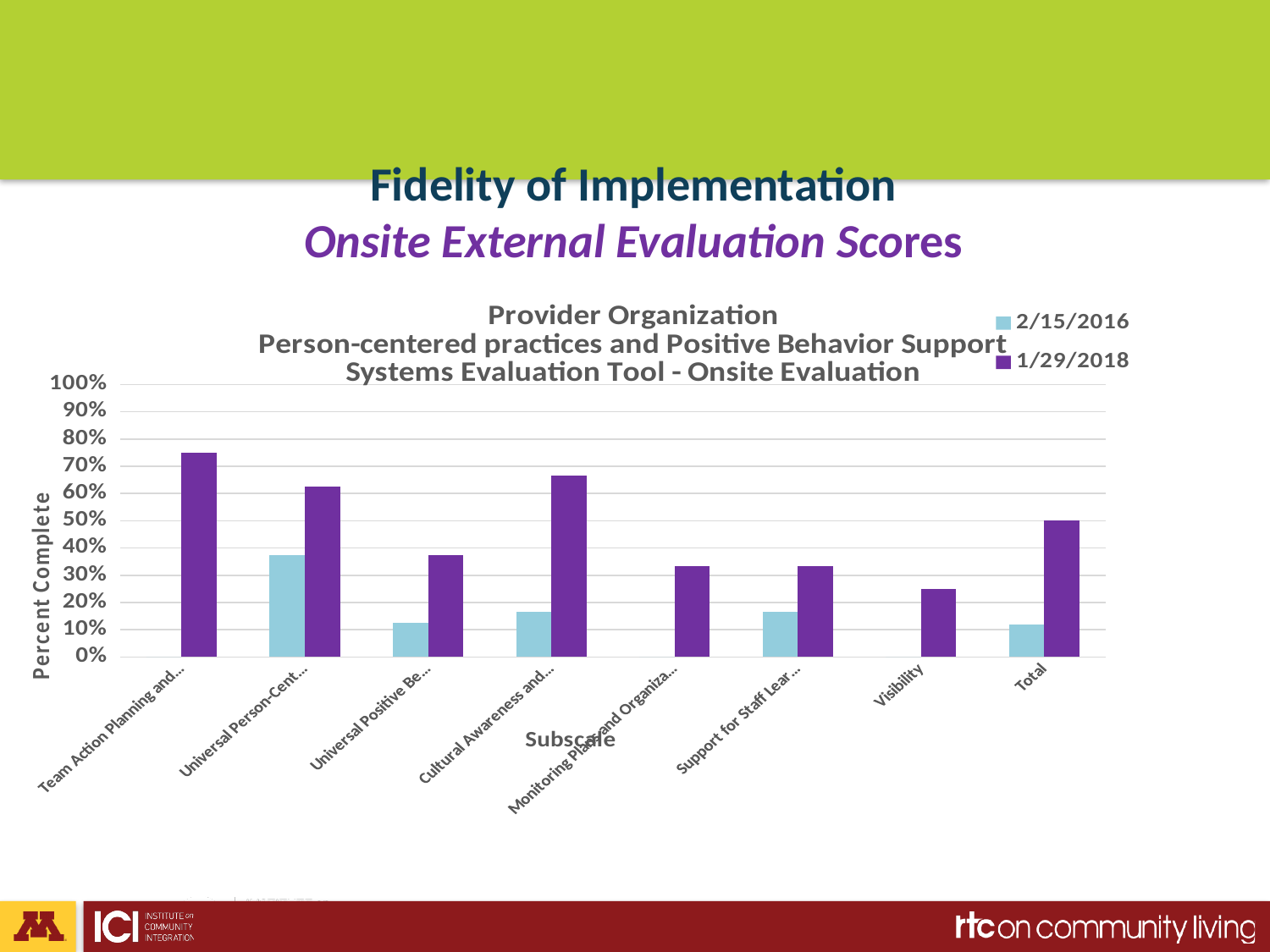
How many series does the legend list? 2 Which colour represents the 1/29/2018 series in the legend? purple Is the 2/15/2016 value for Total greater or less than 20%? less Which category has the lowest non-zero value for the 1/29/2018 series? Visibility Which category has the highest value for the 1/29/2018 series? Team Action Planning and... How many subscale categories are shown on the x axis? 8 For Total, which series has the larger value, 2/15/2016 or 1/29/2018? 1/29/2018 Is the 1/29/2018 value for Visibility greater or less than 30%? less Which category has the highest value for the 2/15/2016 series? Universal Person-Cent... Is the 1/29/2018 value for Total greater or less than 40%? greater What kind of chart is shown on the slide? bar chart What is the label of the y axis? Percent Complete